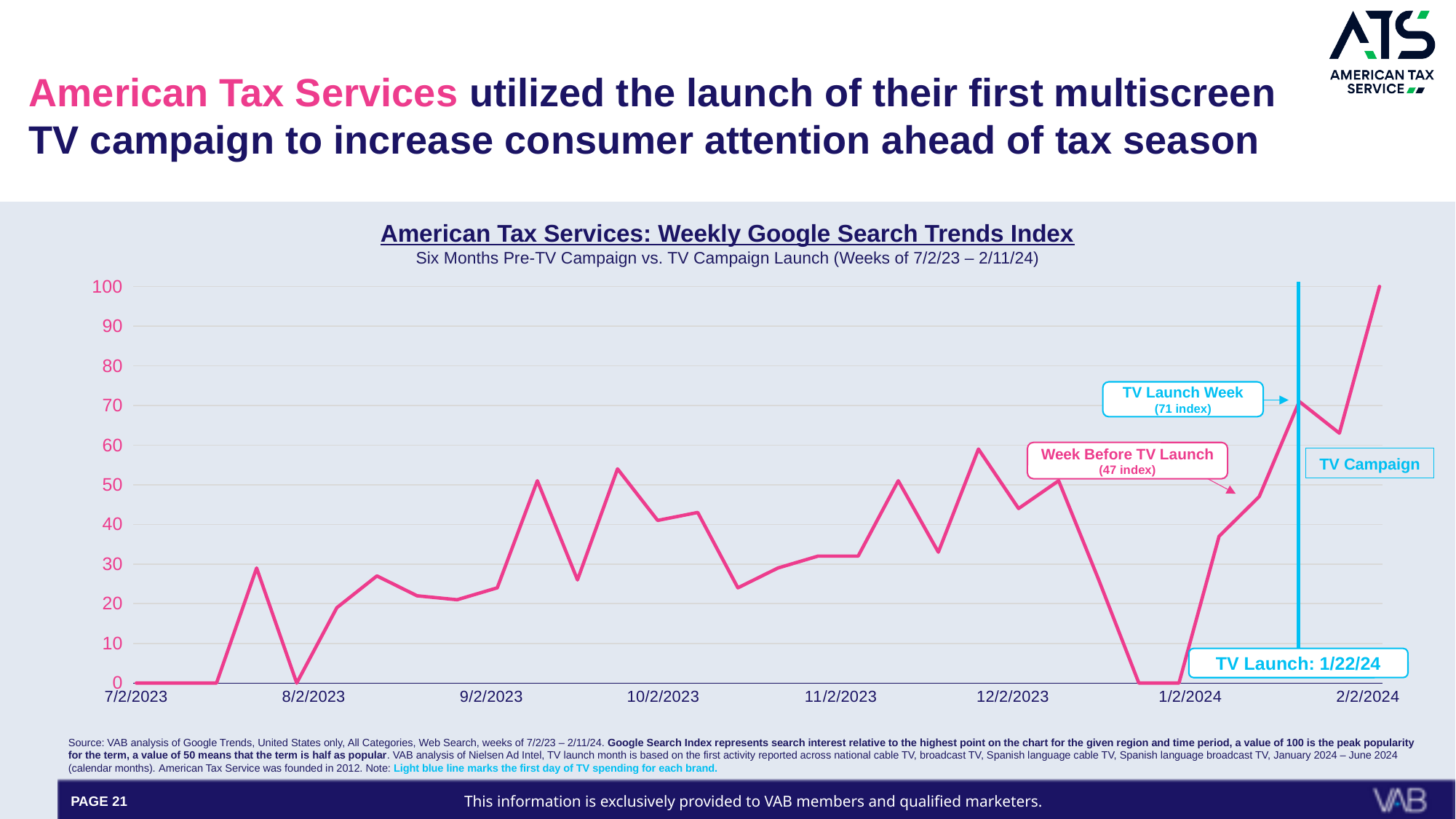
By how much did the index rise from the Week Before TV Launch to the TV Launch Week? 24 What is the index value for the Week Before TV Launch? 47 What date does the chart give for the TV launch? 1/22/24 Which is higher, the index for the TV Launch Week or the Week Before TV Launch? TV Launch Week Is the index value for the week of 1/2/2024 greater or less than 10? less Does the index rise or fall from the Week Before TV Launch to the final week on the chart? rise What is the index value at the start of the chart, the week of 7/2/2023? 0 What is the highest index value reached on the chart? 100 What kind of chart is shown on the slide? line chart Is the index value for the week of 11/2/2023 greater or less than 20? greater What is the Google Search Trends Index value for the TV Launch Week? 71 Is the index value for the week of 9/2/2023 greater or less than 30? less